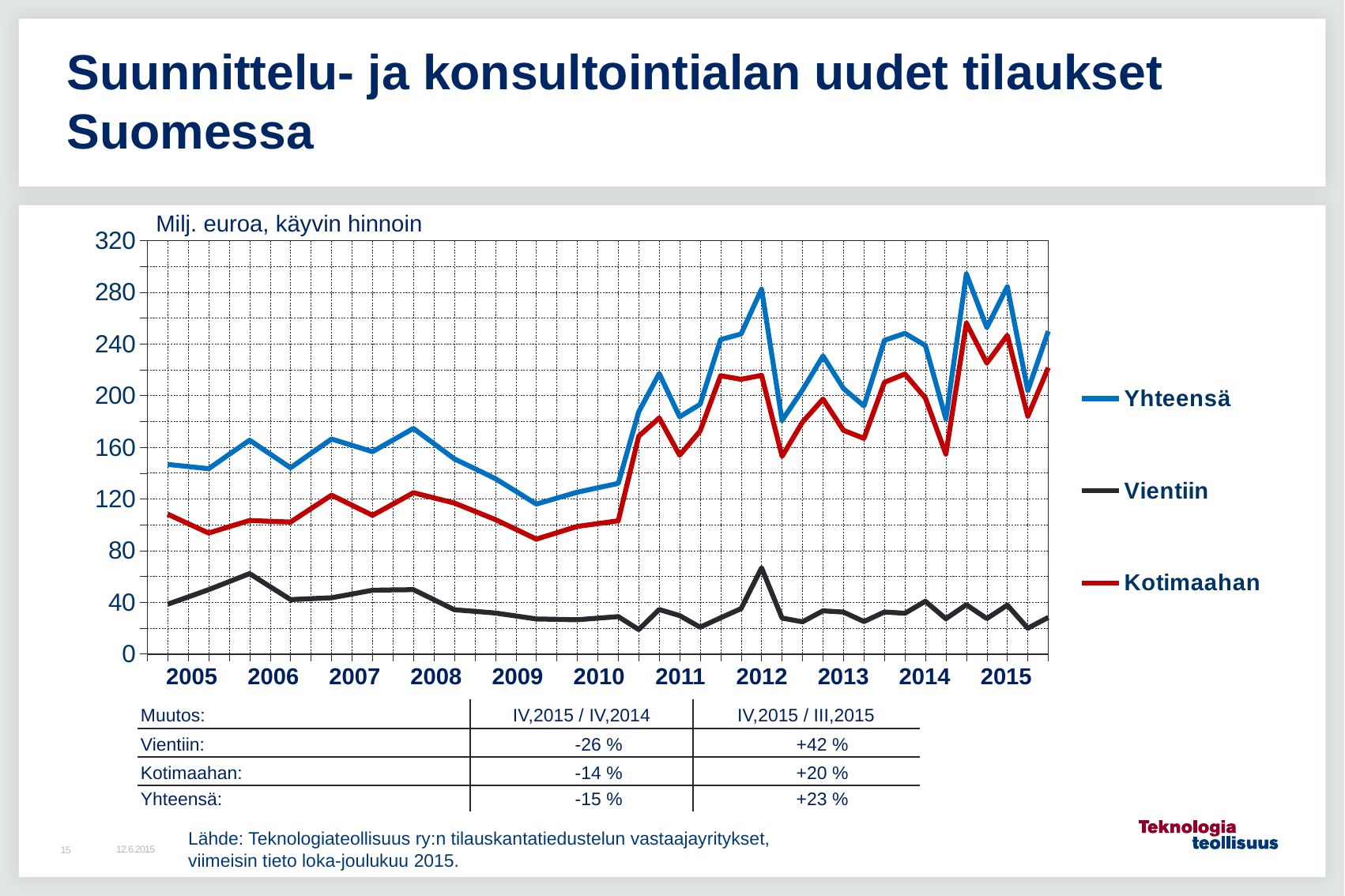
Does the Yhteensä series overall rise or fall from 2005 to 2015? rise Which series are listed in the legend? Yhteensä, Vientiin, Kotimaahan How many years are labelled on the x axis? 11 Which series has the lowest values throughout the chart? Vientiin Is the peak value of Yhteensä in 2014 greater or less than 280? greater Is the peak value of Vientiin in 2012 greater or less than 80? less Which series has the highest values throughout the chart? Yhteensä What unit is stated above the chart? Milj. euroa, käyvin hinnoin What kind of chart is shown on the slide? line chart Which series is larger in 2012, Kotimaahan or Vientiin? Kotimaahan How many series does the legend list? 3 Is the lowest value of Kotimaahan in 2009 greater or less than 80? greater